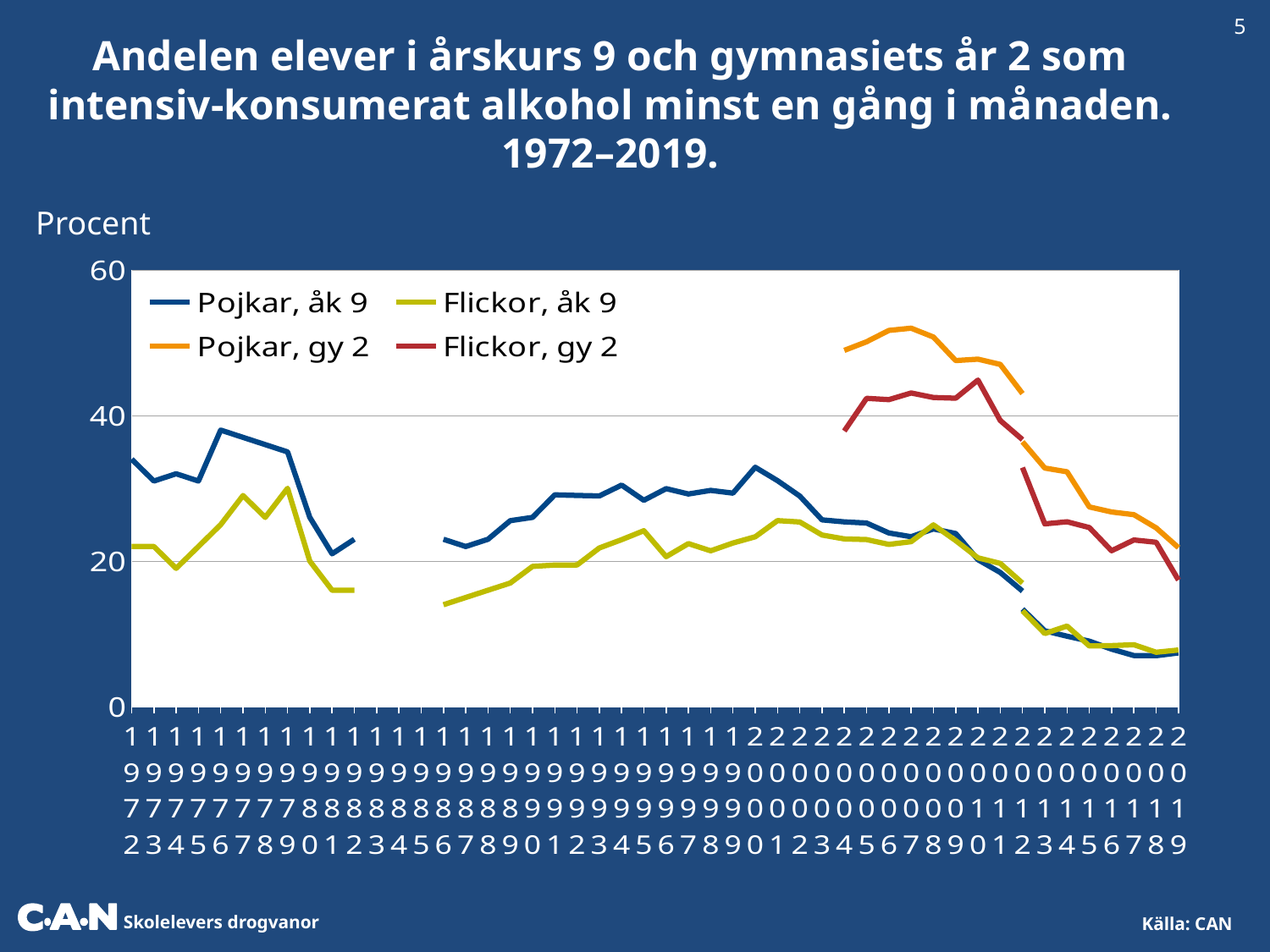
Does the Pojkar, gy 2 series rise or fall between 2005 and 2019? Fall Is the value for Flickor, gy 2 in 2019 greater or less than 20? less How many series does the legend list? 4 Is the value for Pojkar, åk 9 in 2019 greater or less than 20? less Which series are listed in the chart legend? Pojkar, åk 9; Flickor, åk 9; Pojkar, gy 2; Flickor, gy 2 Which series reaches the highest value anywhere on the chart? Pojkar, gy 2 What is the label shown above the vertical axis of the chart? Procent In 2005, which is higher: Pojkar, gy 2 or Pojkar, åk 9? Pojkar, gy 2 What kind of chart is shown on the slide? Line chart In 2019, which is higher: Pojkar, gy 2 or Flickor, gy 2? Pojkar, gy 2 Is the value for Pojkar, gy 2 in 2005 greater or less than 40? greater